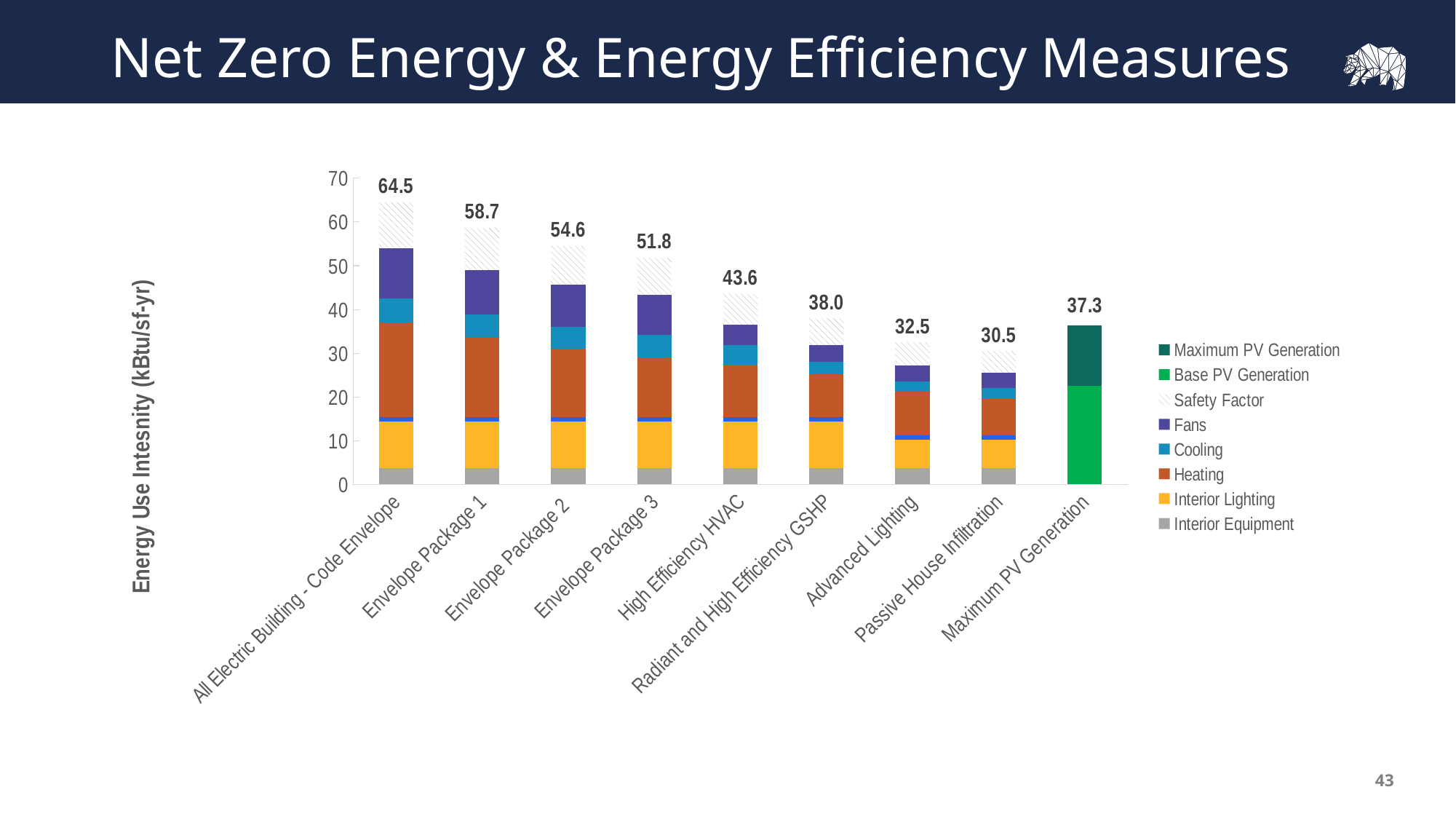
What kind of chart is shown on the slide? Stacked bar chart How many categories are shown on the x axis? 9 What is the labeled total for All Electric Building - Code Envelope? 64.5 How many series does the legend list? 8 What is the difference between the labeled totals for All Electric Building - Code Envelope and Passive House Infiltration? 34.0 Which category has the lowest labeled total? Passive House Infiltration What is the difference between the labeled totals for High Efficiency HVAC and Radiant and High Efficiency GSHP? 5.6 What is the labeled value for Maximum PV Generation? 37.3 Which category has the highest labeled total? All Electric Building - Code Envelope Which has a larger labeled total, Envelope Package 3 or Advanced Lighting? Envelope Package 3 What is the labeled total for Radiant and High Efficiency GSHP? 38.0 Do the labeled totals rise or fall from All Electric Building - Code Envelope to Passive House Infiltration? Fall